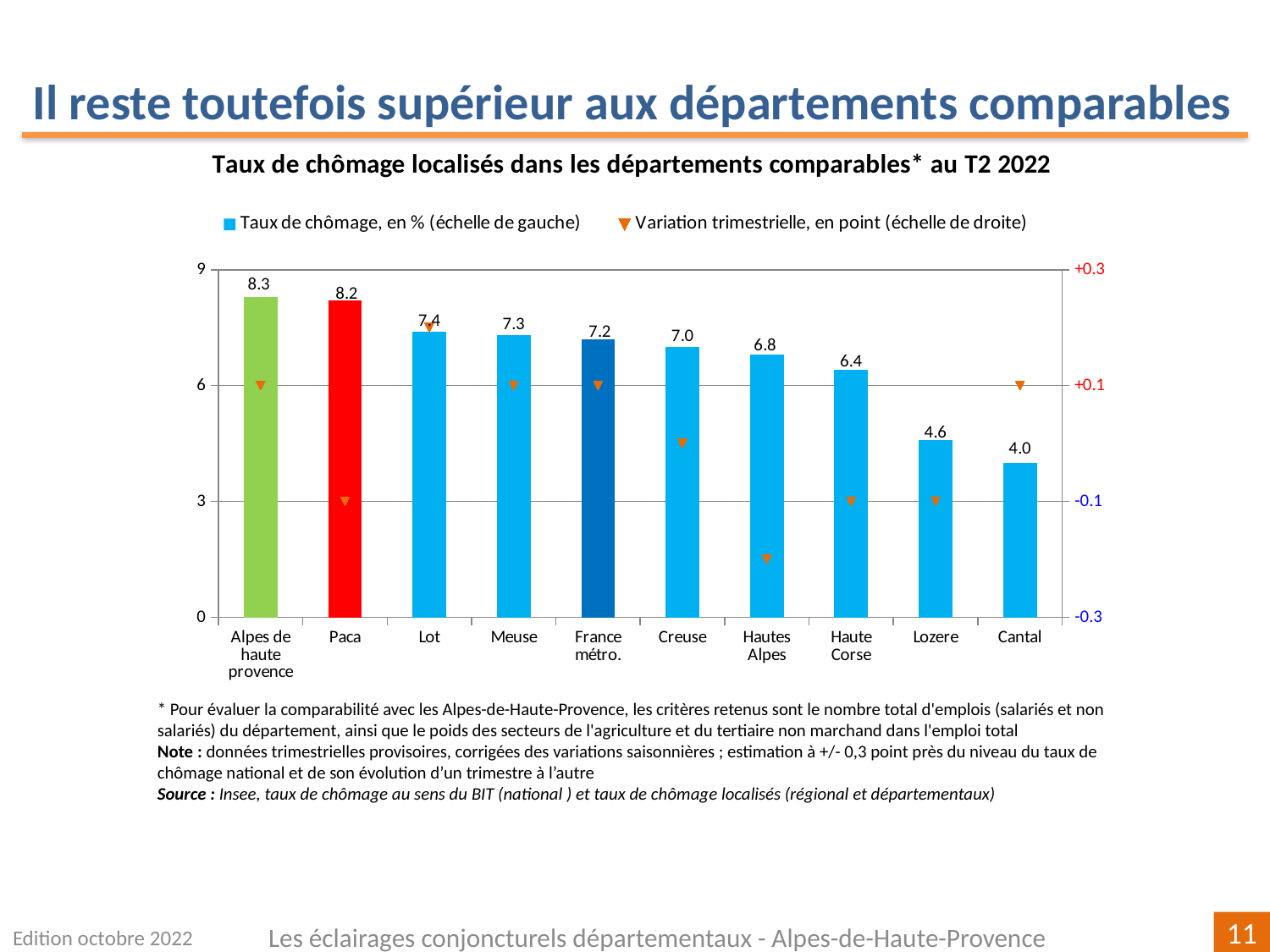
Which has a higher unemployment rate, Creuse or Hautes Alpes? Creuse Is the unemployment rate for Haute Corse greater or less than 6? greater How many series does the legend list? 2 Do the unemployment rates rise or fall from left to right along the x axis? Fall Which department has the lowest unemployment rate on the chart? Cantal What is the unemployment rate shown for France métro.? 7.2 What kind of chart is used to show the unemployment rates? Bar chart Which department or area has the highest unemployment rate on the chart? Alpes de haute provence What is the difference between the unemployment rates of Paca and Lozere? 3.6 What is the unemployment rate (Taux de chômage) for Alpes de haute provence? 8.3 What is the unemployment rate shown for Cantal? 4.0 How many departments or areas are shown on the x axis? 10